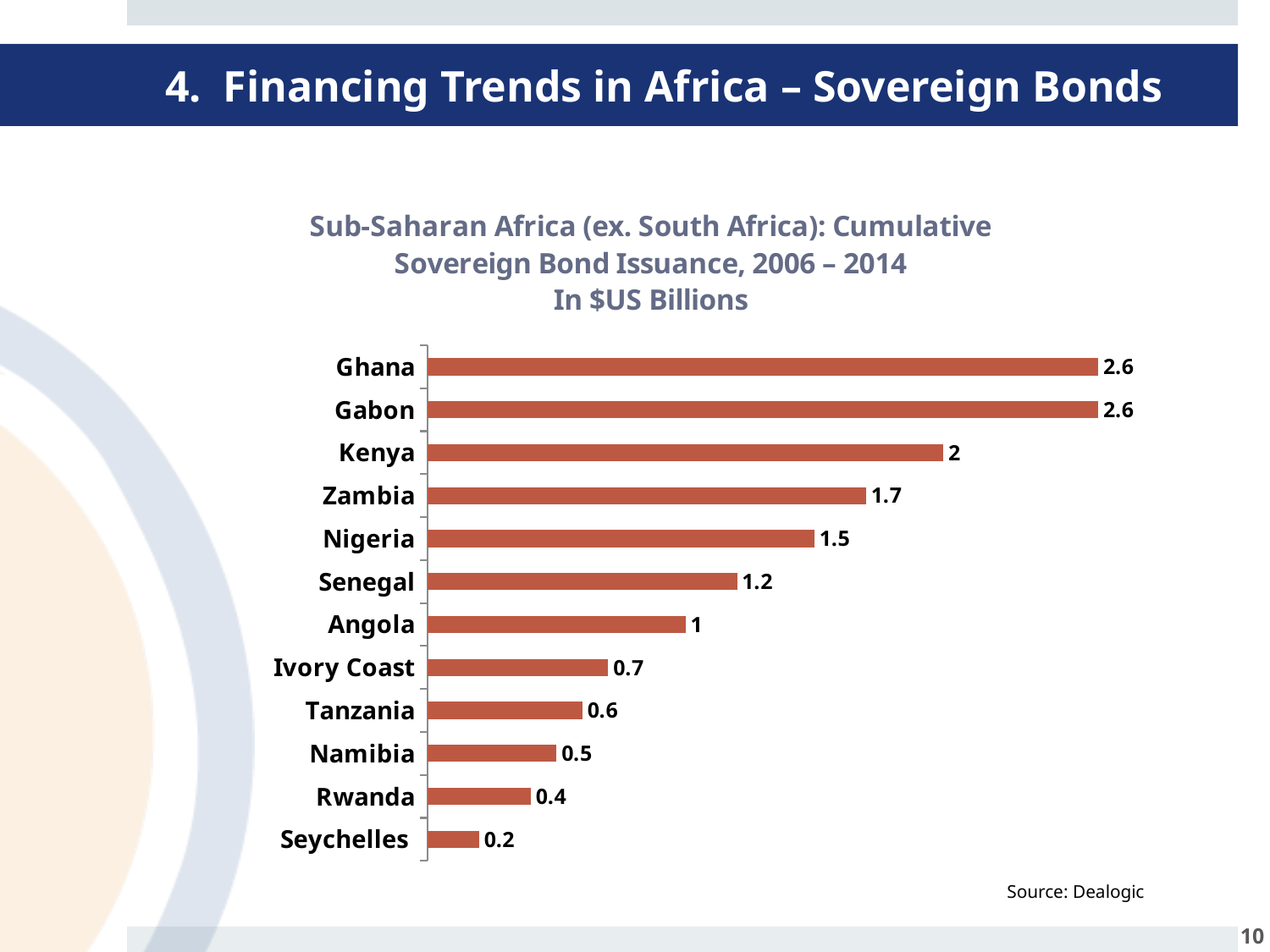
How many countries are shown in the chart? 12 What value is shown for Ivory Coast? 0.7 What value is shown for Rwanda? 0.4 Which has a larger value, Namibia or Senegal? Senegal What unit are the values in the chart expressed in, according to the chart title? $US Billions What kind of chart is shown on the slide? Bar chart What is the difference between the values for Ghana and Kenya? 0.6 What is the difference between the values for Zambia and Senegal? 0.5 What is the cumulative sovereign bond issuance value shown for Kenya? 2 Which country has the lowest cumulative sovereign bond issuance in the chart? Seychelles Which has a larger value, Angola or Tanzania? Angola What value is shown for Nigeria? 1.5